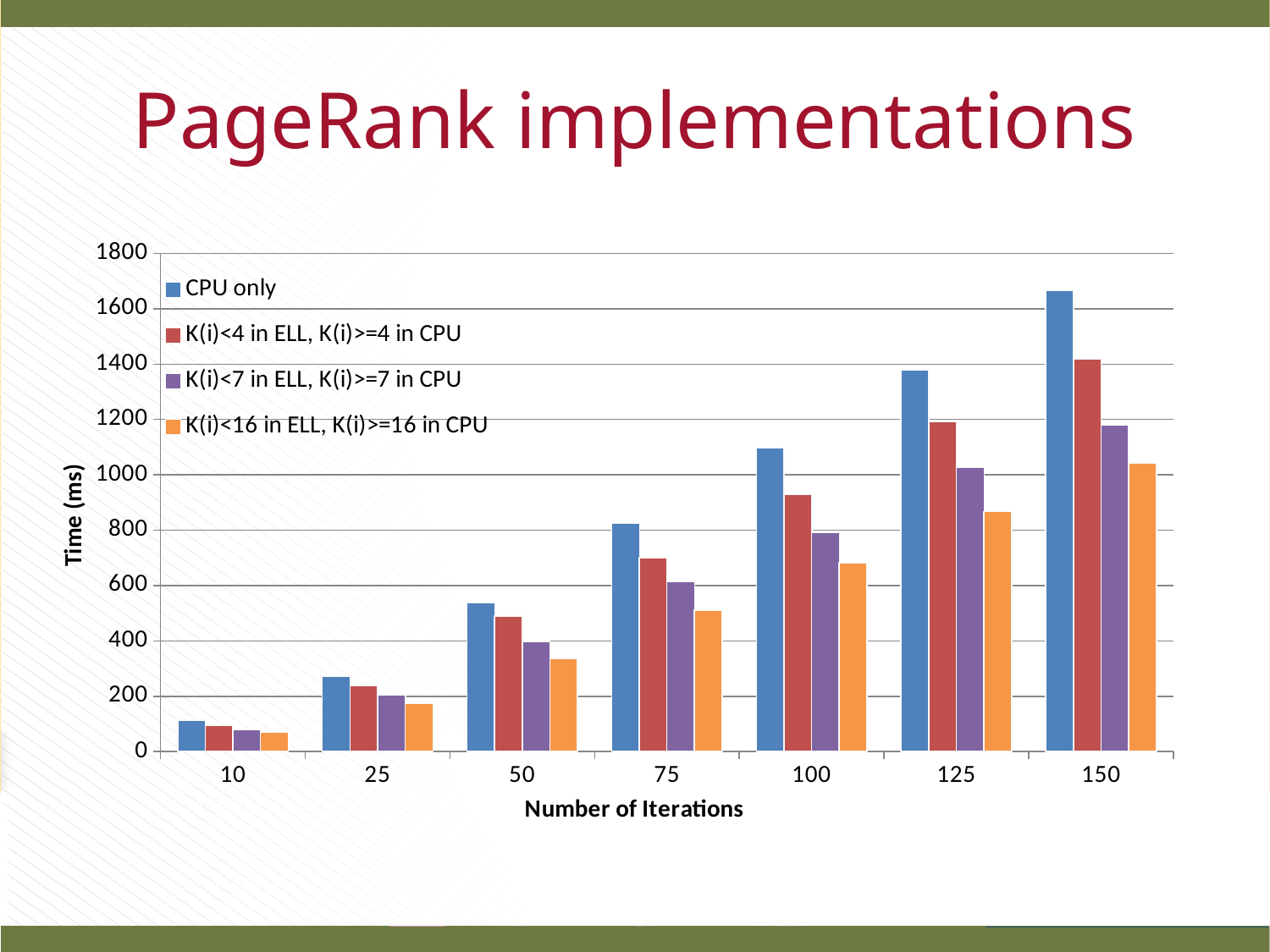
How many iteration counts are shown on the x axis? 7 Which is larger at 100 iterations: CPU only or K(i)<7 in ELL, K(i)>=7 in CPU? CPU only Is the value for K(i)<16 in ELL, K(i)>=16 in CPU at 125 iterations greater or less than 1000? less Does the time for CPU only rise or fall as the number of iterations increases? rise Which series has the lowest time at 125 iterations? K(i)<16 in ELL, K(i)>=16 in CPU What is the label of the y axis? Time (ms) How many series does the legend list? 4 Is the value for K(i)<4 in ELL, K(i)>=4 in CPU at 75 iterations greater or less than 800? less Which series has the highest time at 150 iterations? CPU only Is the value for CPU only at 100 iterations greater or less than 1000? greater What type of chart is shown on the slide? bar chart